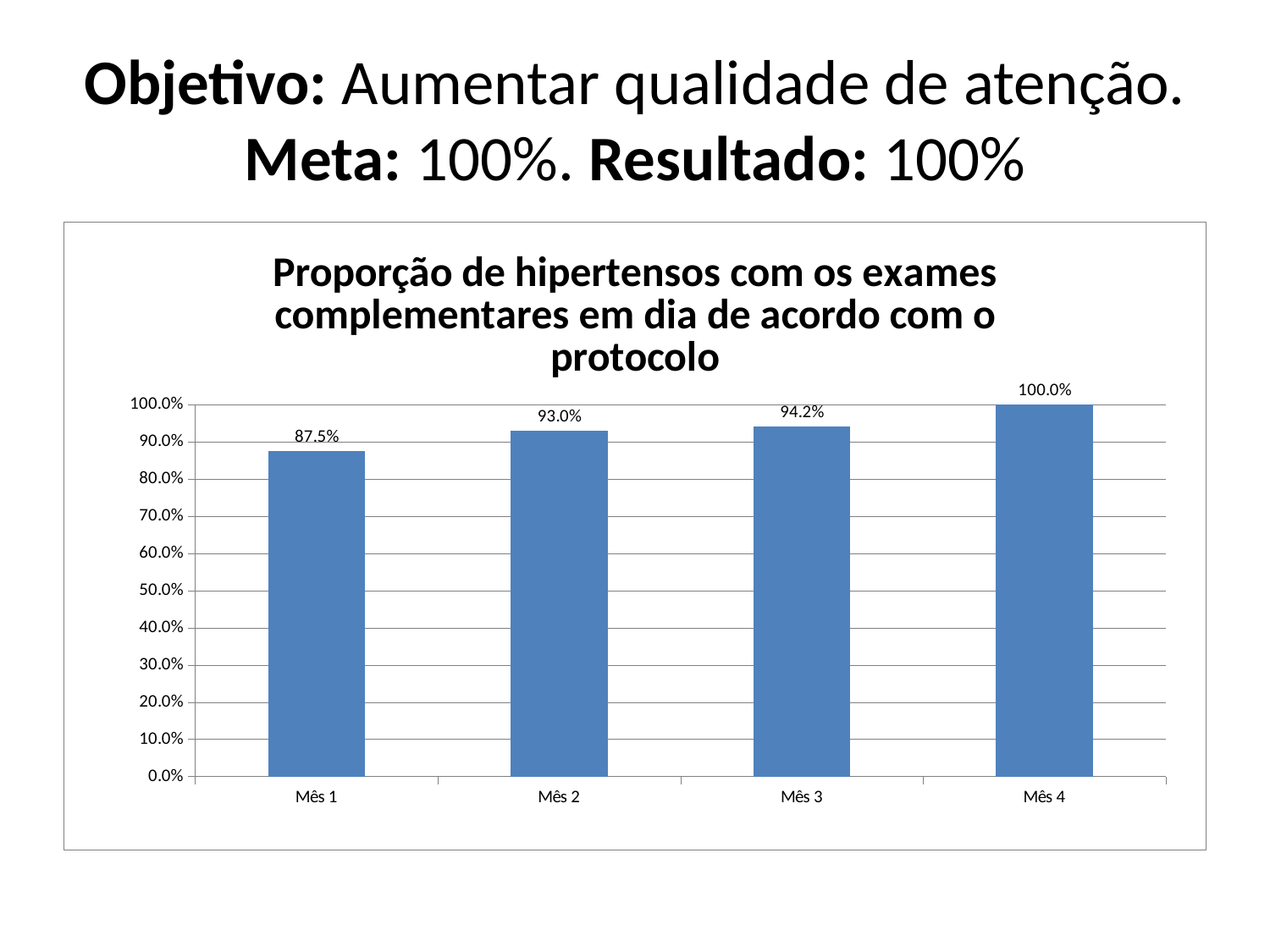
What is the value for Mês 4? 100.0% Which month has the lowest value? Mês 1 Which is larger, the value for Mês 2 or the value for Mês 1? Mês 2 Which month has the highest value? Mês 4 What is the difference between the values for Mês 3 and Mês 2? 1.2% What is the value for Mês 1? 87.5% What is the value for Mês 2? 93.0% What is the difference between the values for Mês 4 and Mês 1? 12.5% How many months are shown on the x axis? 4 What is the value for Mês 3? 94.2% Do the values rise or fall from Mês 1 to Mês 4? Rise What kind of chart is shown on the slide? Bar chart